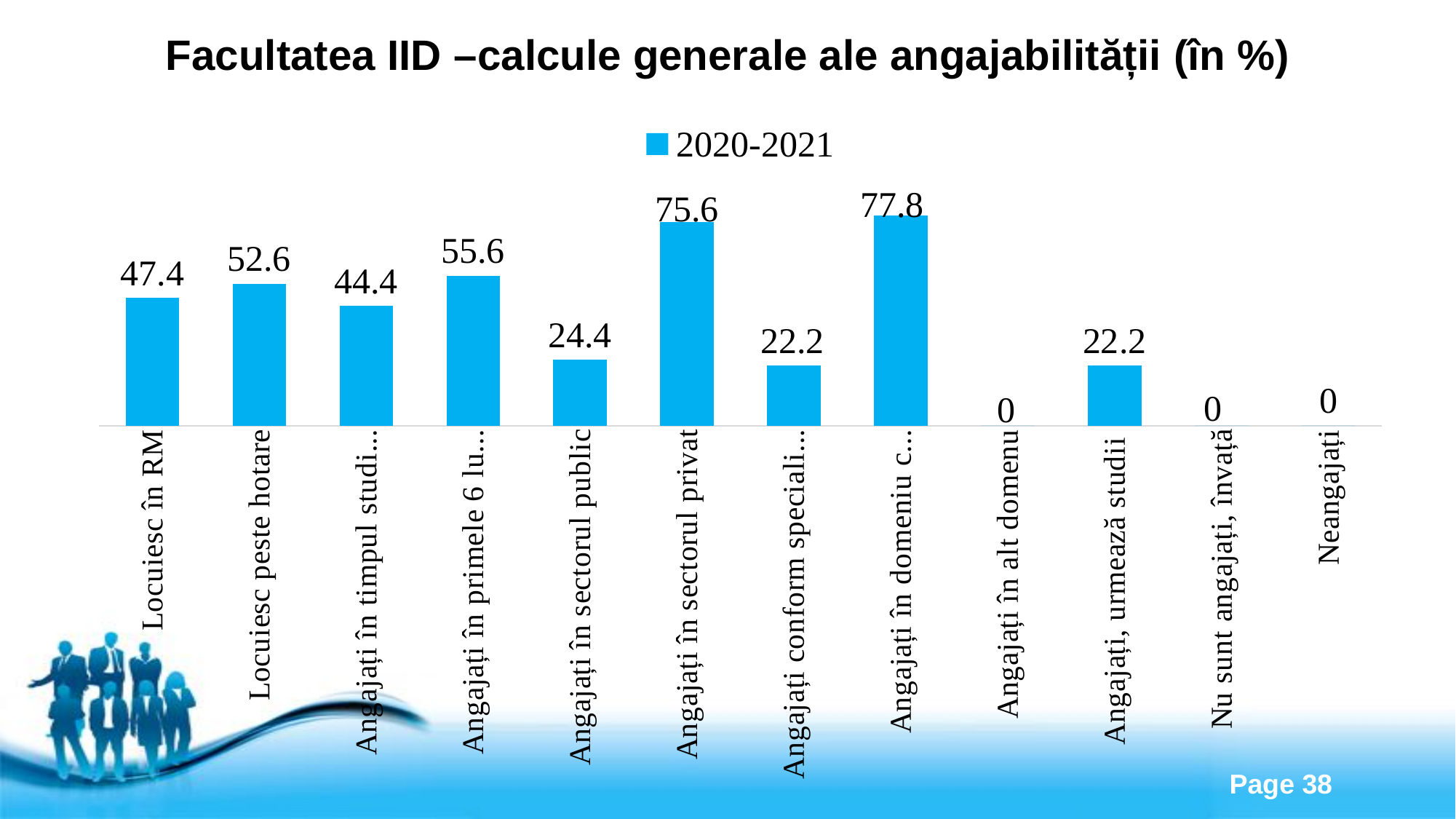
What is the difference between the values for "Angajați în sectorul privat" and "Angajați în sectorul public"? 51.2 What kind of chart is shown on the slide? Bar chart Which is larger, the value for "Locuiesc în RM" or for "Locuiesc peste hotare"? Locuiesc peste hotare What series name is shown in the chart legend? 2020-2021 How many categories are shown on the x axis of the chart? 12 What is the value for "Locuiesc peste hotare"? 52.6 What is the value for "Locuiesc în RM"? 47.4 What is the value for "Angajați în sectorul public"? 24.4 What is the value for "Angajați, urmează studii"? 22.2 What is the value for "Neangajați"? 0 What is the value for "Angajați în sectorul privat"? 75.6 How many series does the legend list? 1